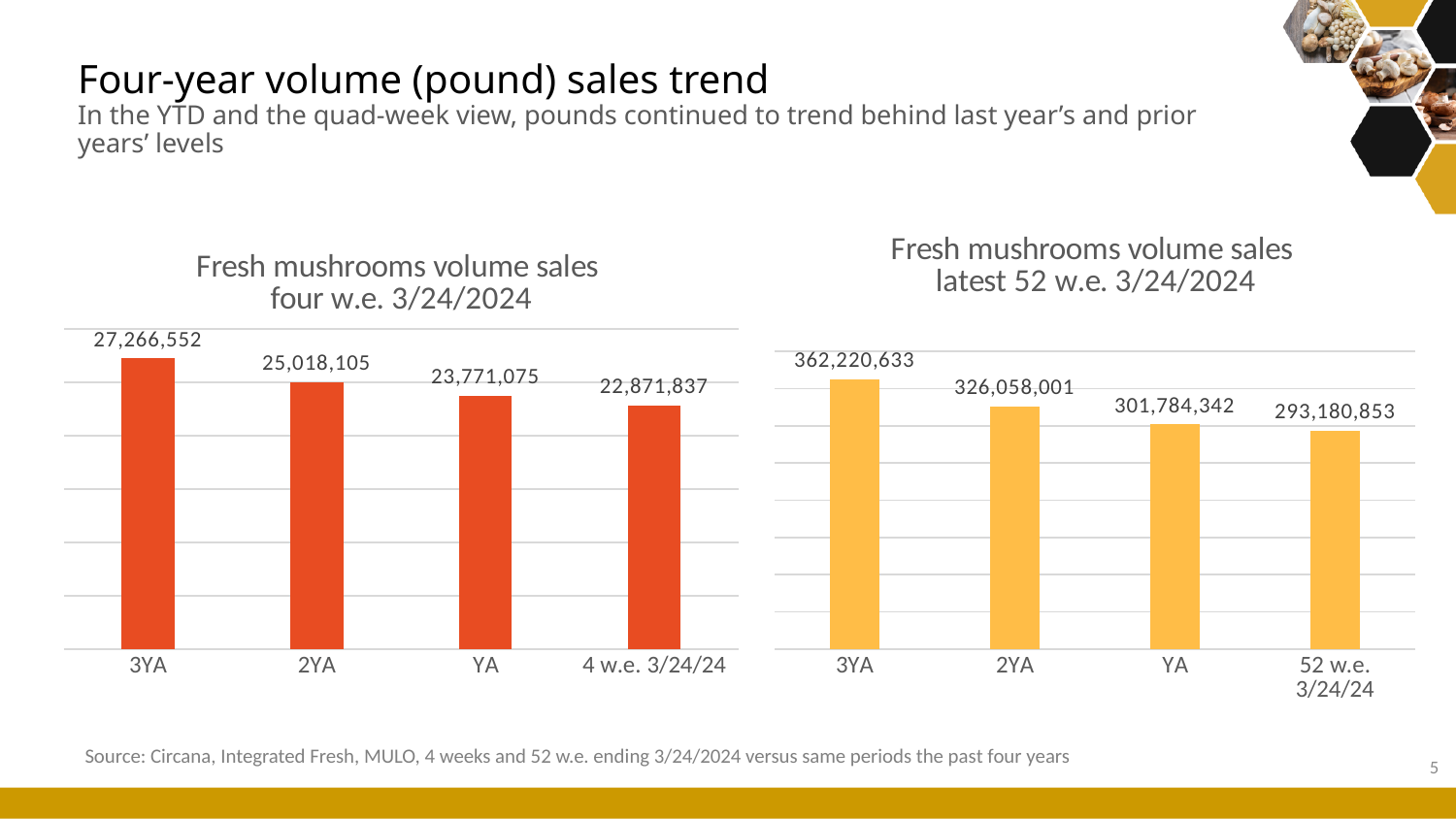
How many categories are shown in the 'Fresh mushrooms volume sales four w.e. 3/24/2024' chart? 4 In the 'Fresh mushrooms volume sales latest 52 w.e. 3/24/2024' chart, which category has the lowest value? 52 w.e. 3/24/24 In the 'Fresh mushrooms volume sales four w.e. 3/24/2024' chart, what is the value for 4 w.e. 3/24/24? 22,871,837 In the 'Fresh mushrooms volume sales four w.e. 3/24/2024' chart, what is the difference between the 2YA and YA values? 1,247,030 In the 'Fresh mushrooms volume sales latest 52 w.e. 3/24/2024' chart, what is the difference between the 3YA and 2YA values? 36,162,632 In the 'Fresh mushrooms volume sales four w.e. 3/24/2024' chart, what is the value for 3YA? 27,266,552 What kind of chart is the 'Fresh mushrooms volume sales latest 52 w.e. 3/24/2024' chart? Bar chart In the 'Fresh mushrooms volume sales latest 52 w.e. 3/24/2024' chart, what is the value for YA? 301,784,342 In the 'Fresh mushrooms volume sales four w.e. 3/24/2024' chart, which category has the highest value? 3YA In the 'Fresh mushrooms volume sales four w.e. 3/24/2024' chart, do the values rise or fall from 3YA to 4 w.e. 3/24/24? Fall In the 'Fresh mushrooms volume sales latest 52 w.e. 3/24/2024' chart, what is the value for 52 w.e. 3/24/24? 293,180,853 In the 'Fresh mushrooms volume sales latest 52 w.e. 3/24/2024' chart, which is larger, the value for 2YA or the value for YA? 2YA